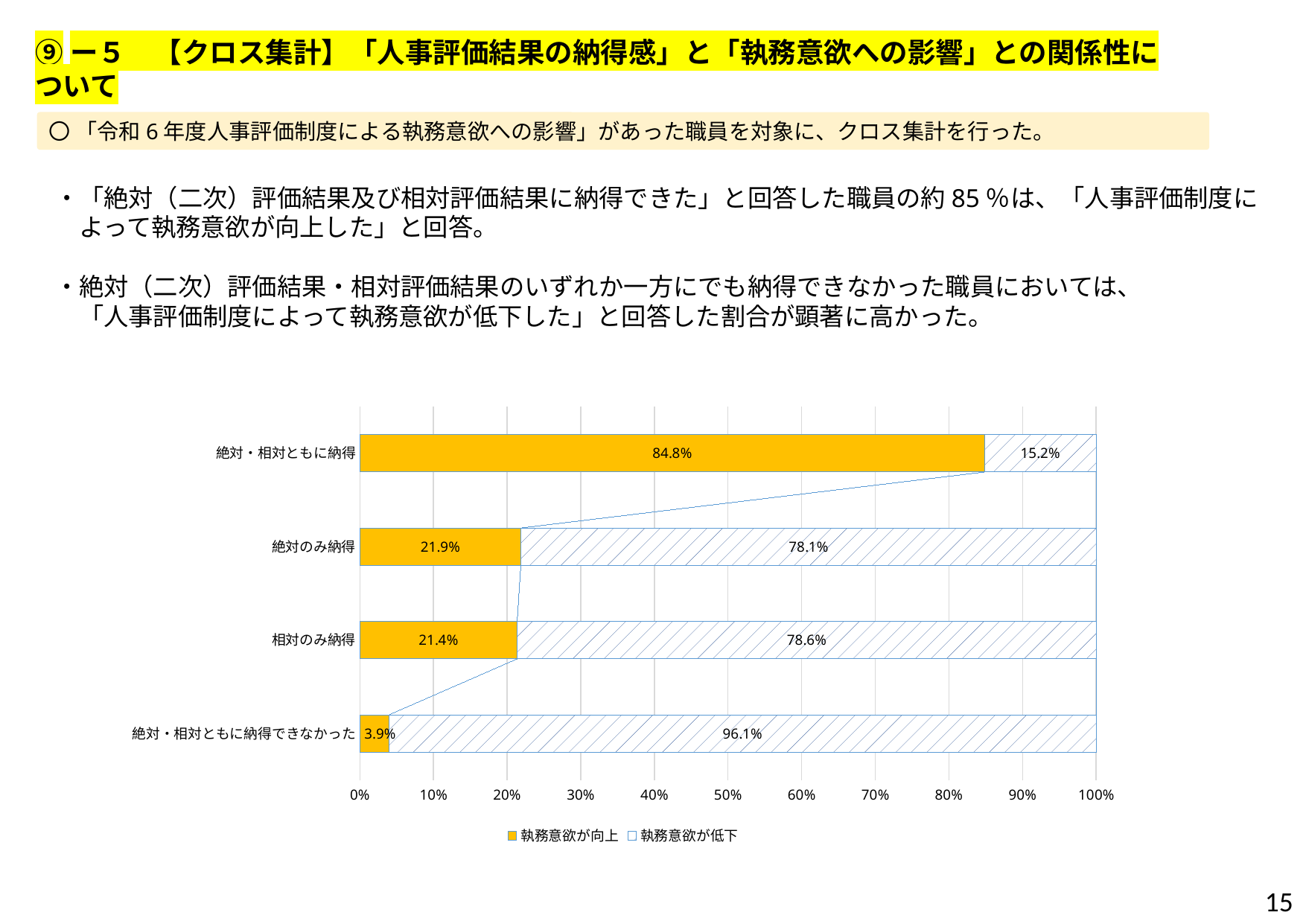
What is the value of 執務意欲が向上 for 絶対・相対ともに納得? 84.8% Which category has the highest value for 執務意欲が向上? 絶対・相対ともに納得 What is the value of 執務意欲が低下 for 絶対のみ納得? 78.1% What is the difference between the 執務意欲が向上 values for 絶対・相対ともに納得 and 絶対のみ納得? 62.9% What is the value of 執務意欲が低下 for 絶対・相対ともに納得できなかった? 96.1% How many categories are shown on the chart? 4 What is the value of 執務意欲が向上 for 相対のみ納得? 21.4% Which series is shown in orange? 執務意欲が向上 What kind of chart is shown on the slide? Stacked bar chart Which is larger: the 執務意欲が低下 value for 絶対のみ納得 or for 相対のみ納得? 相対のみ納得 Which category has the lowest value for 執務意欲が向上? 絶対・相対ともに納得できなかった How many series does the legend list? 2